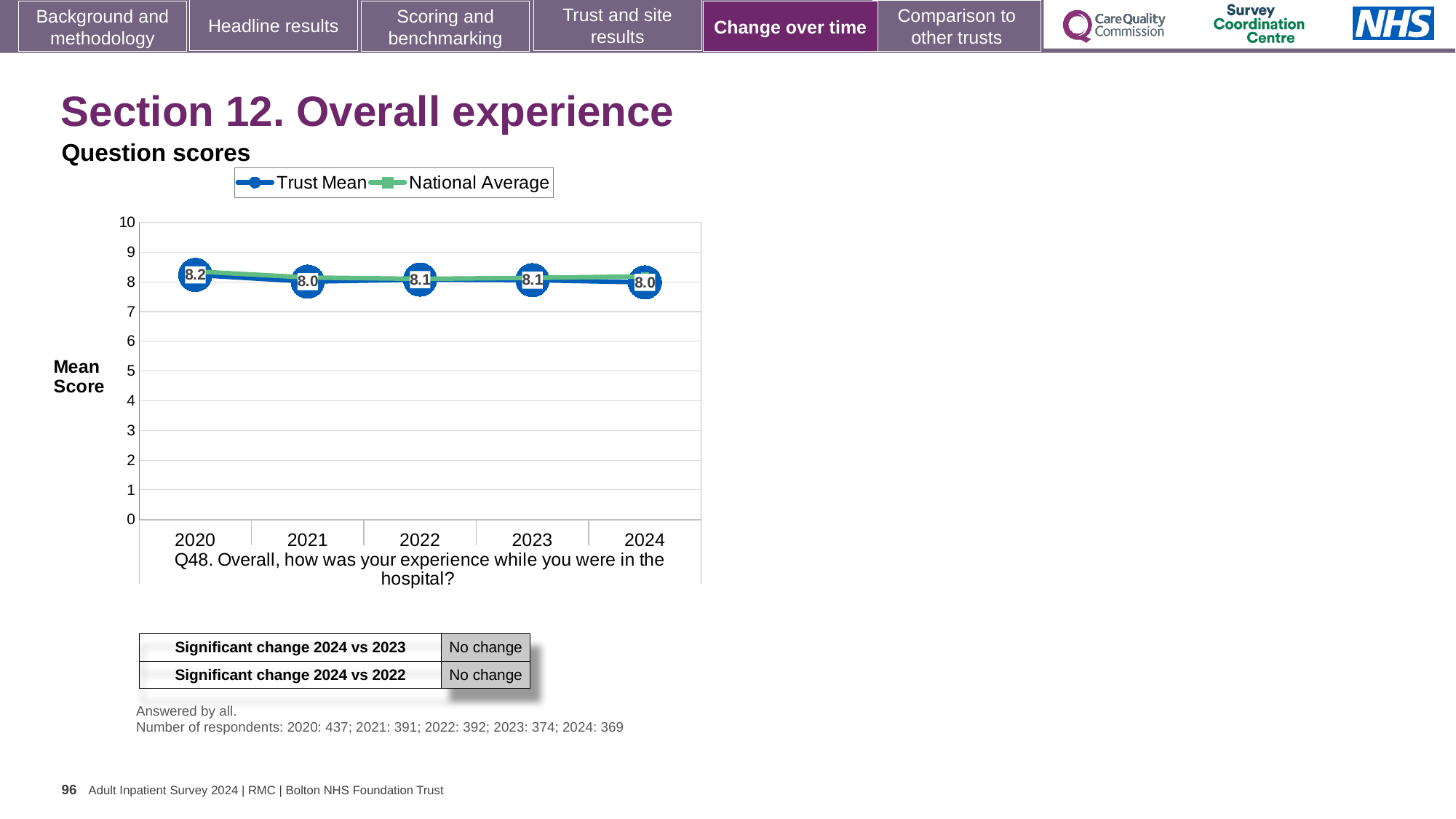
How many series does the legend list? 2 What kind of chart is shown on the slide? Line chart How many years are plotted on the x axis? 5 What is the label on the y axis of the chart? Mean Score What is the Trust Mean score for 2020? 8.2 Is the National Average value for 2022 greater or less than 5? greater In which year is the Trust Mean score highest? 2020 Which is larger, the Trust Mean score for 2020 or for 2024? 2020 What is the Trust Mean score for 2024? 8.0 Does the Trust Mean score rise or fall from 2020 to 2021? Fall What is the Trust Mean score for 2022? 8.1 What is the difference between the Trust Mean scores for 2020 and 2021? 0.2